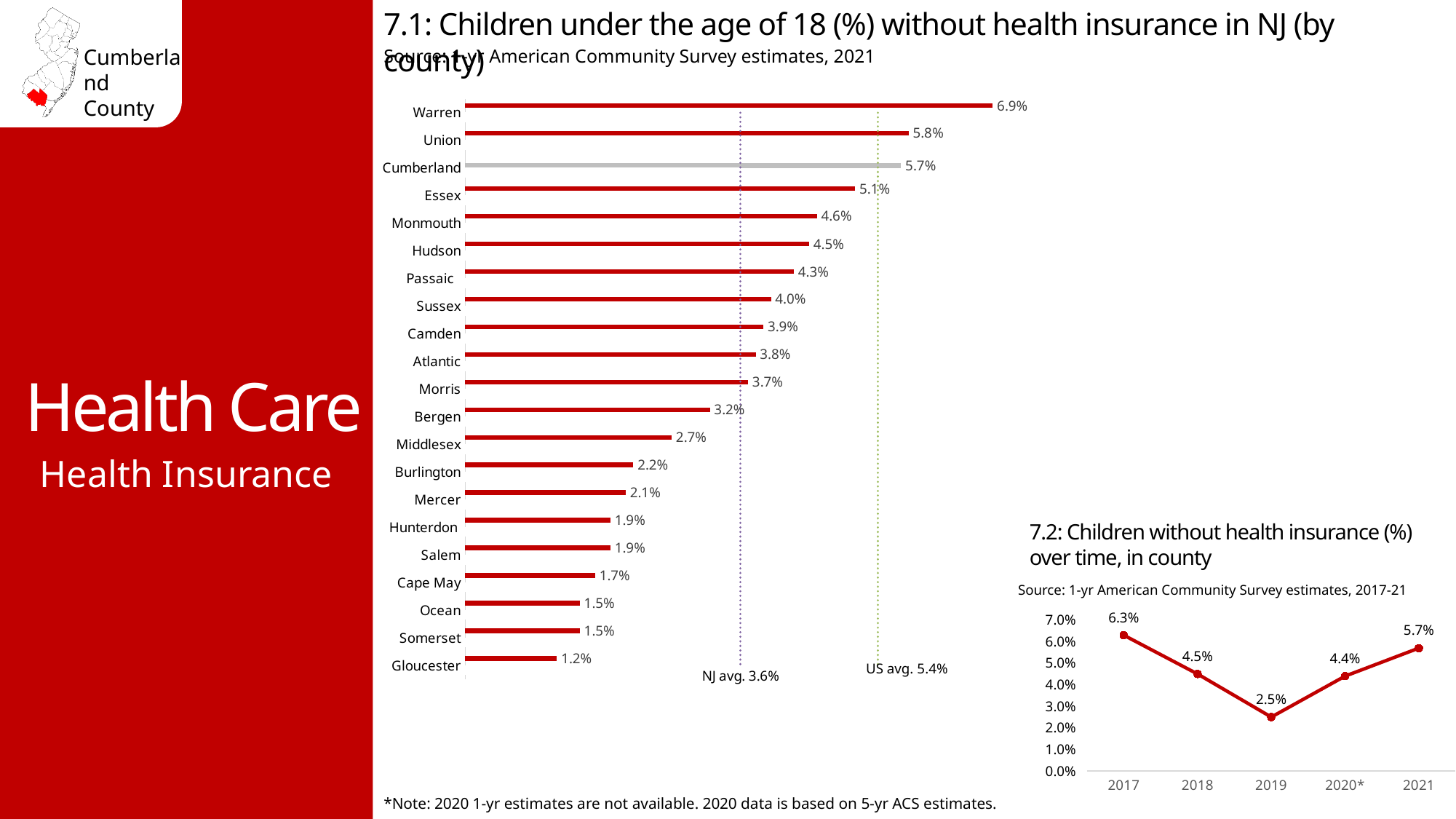
In chart 7.1, which county has a larger value, Essex or Monmouth? Essex In chart 7.2, which year has the highest value? 2017 What kind of chart is chart 7.1? Bar chart In chart 7.2 (children without health insurance over time, in county), what is the value for 2019? 2.5% In chart 7.1, what is the NJ average shown by the dotted reference line? 3.6% In chart 7.2, what is the difference between the values for 2021 and 2020*? 1.3% In chart 7.1, which county has the lowest percentage of children without health insurance? Gloucester In chart 7.1, how many counties are shown? 21 In chart 7.1, which county has the highest percentage of children without health insurance? Warren What kind of chart is chart 7.2? Line chart In chart 7.1, what is the difference between the values for Warren and Gloucester? 5.7% In chart 7.1 (children under 18 without health insurance by county), what is the value for Cumberland? 5.7%